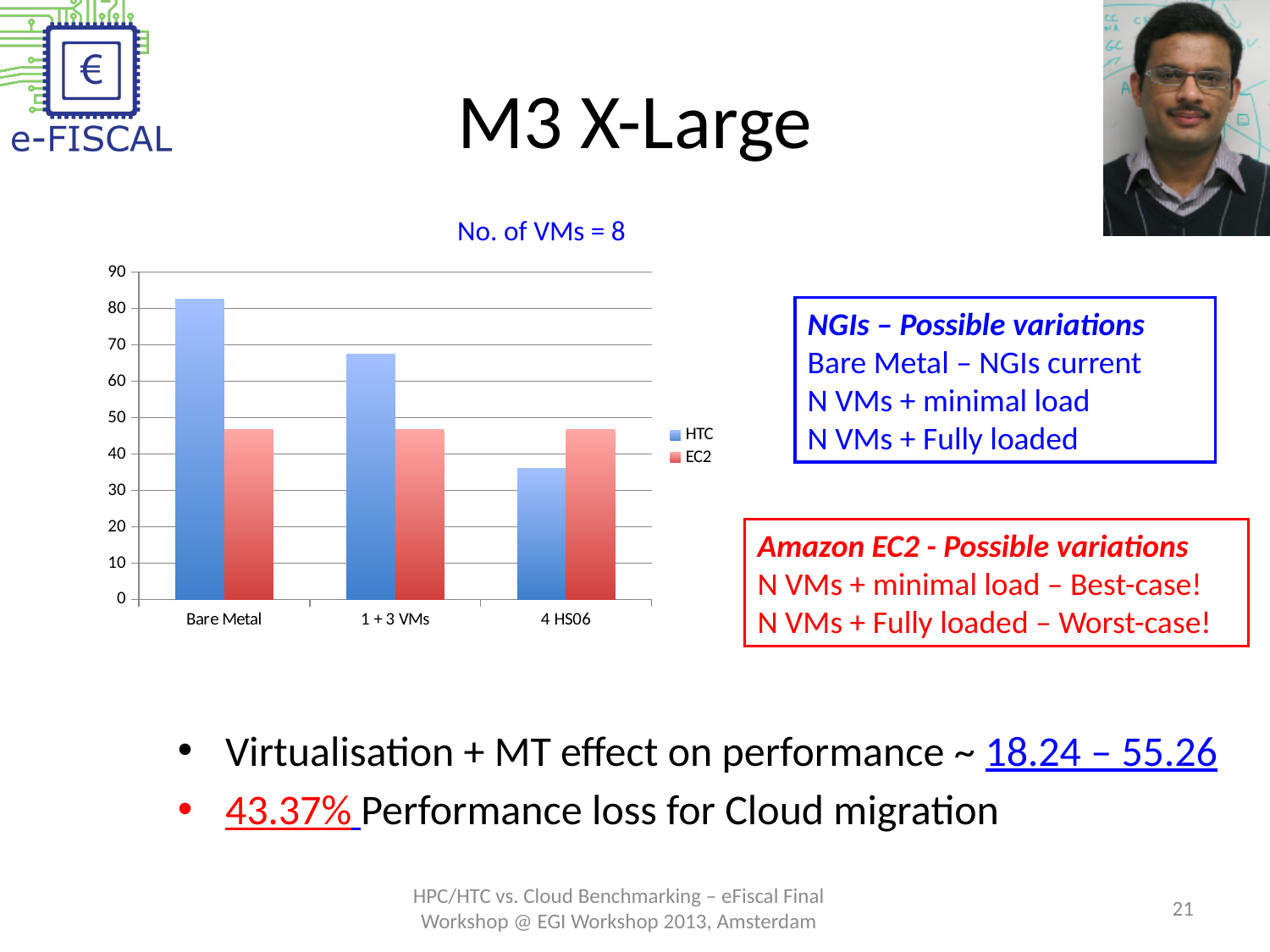
For Bare Metal, which series has the larger value, HTC or EC2? HTC Which category has the highest HTC value? Bare Metal What is the title shown above the chart? No. of VMs = 8 Which category has the lowest HTC value? 4 HS06 How many series does the chart legend list? 2 Is the EC2 value for 1 + 3 VMs greater or less than 50? less What kind of chart is shown on the slide? bar chart Is the HTC value for 4 HS06 greater or less than 40? less Do the HTC values rise or fall from Bare Metal to 4 HS06 along the x axis? fall Is the HTC value for Bare Metal greater or less than 80? greater For 4 HS06, which series has the larger value, HTC or EC2? EC2 How many categories are shown on the x axis of the chart? 3